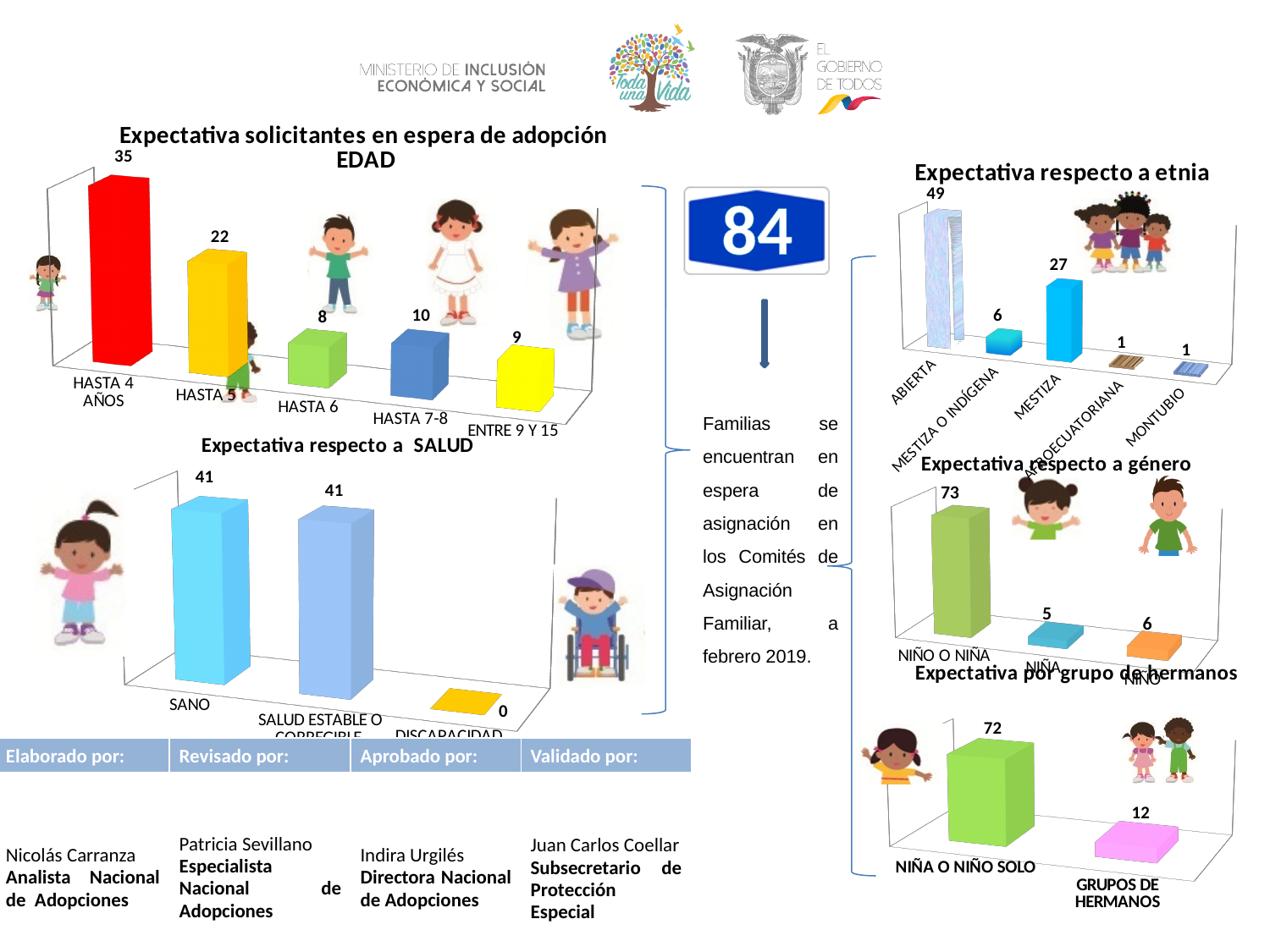
In the 'Expectativa respecto a género' chart, what is the value for NIÑO O NIÑA? 73 In the 'Expectativa solicitantes en espera de adopción EDAD' chart, which category has the lowest value? HASTA 6 In the 'Expectativa respecto a género' chart, which is larger, NIÑA or NIÑO? NIÑO In the 'Expectativa solicitantes en espera de adopción EDAD' chart, what is the value for HASTA 4 AÑOS? 35 In the 'Expectativa solicitantes en espera de adopción EDAD' chart, what is the difference between HASTA 4 AÑOS and HASTA 5? 13 What kind of chart is 'Expectativa por grupo de hermanos'? Bar chart In the 'Expectativa respecto a etnia' chart, which category has the highest value? ABIERTA In the 'Expectativa respecto a SALUD' chart, what is the value for SANO? 41 In the 'Expectativa solicitantes en espera de adopción EDAD' chart, how many categories are shown? 5 In the 'Expectativa respecto a SALUD' chart, what is the value for DISCAPACIDAD? 0 In the 'Expectativa respecto a etnia' chart, what is the value for MESTIZA? 27 In the 'Expectativa por grupo de hermanos' chart, what is the difference between NIÑA O NIÑO SOLO and GRUPOS DE HERMANOS? 60